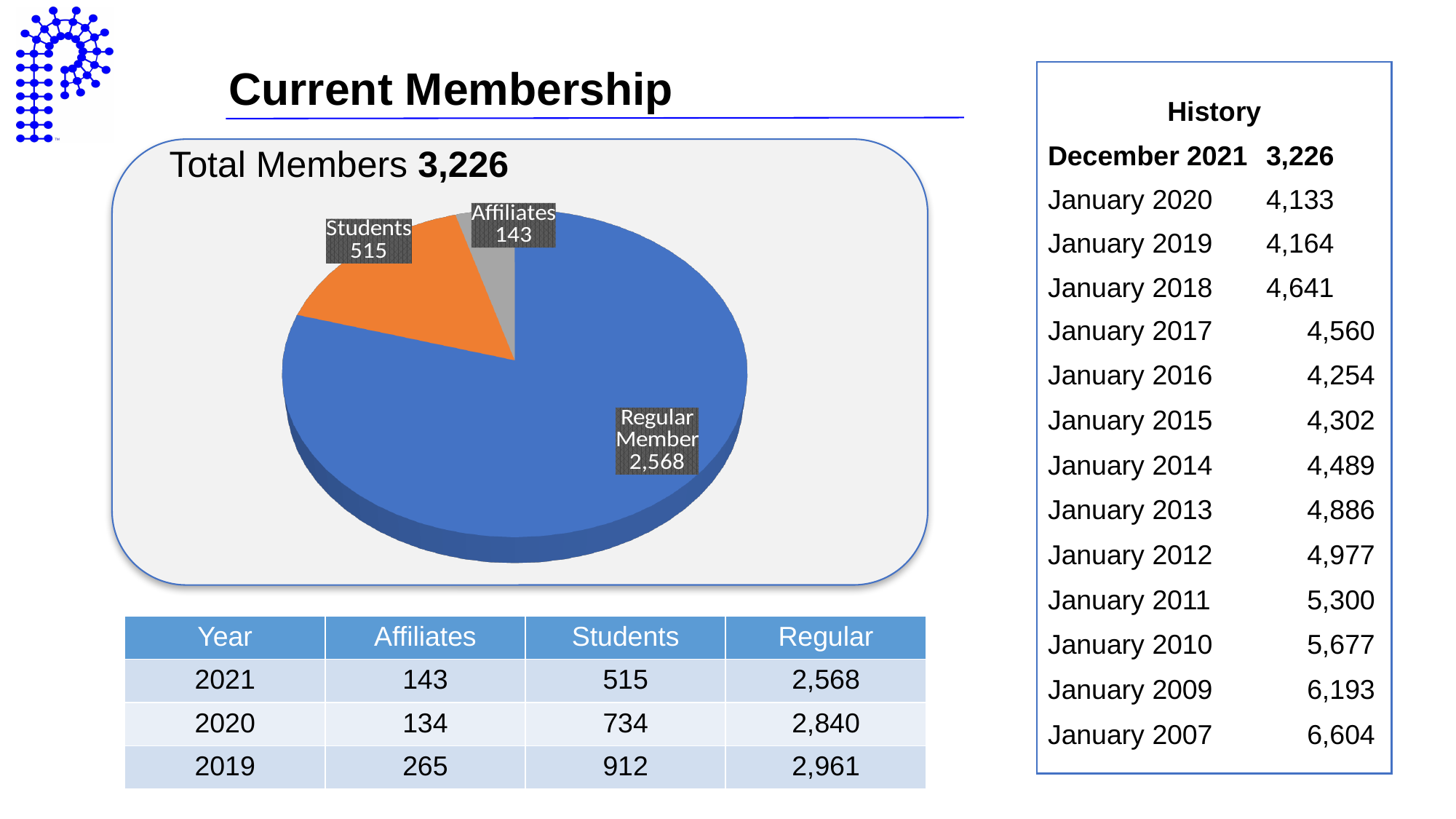
What is the value for Affiliates in the pie chart? 143 Which is larger in the pie chart, Students or Affiliates? Students What is the value for Regular Member in the pie chart? 2,568 What is the difference between the Regular Member and Students values in the pie chart? 2,053 Which category has the smallest slice in the pie chart? Affiliates How many slices does the pie chart have? 3 What colour is the Students slice in the pie chart? orange Which category has the largest slice in the pie chart? Regular Member What kind of chart is shown on the slide? pie chart What is the difference between the Students and Affiliates values in the pie chart? 372 What is the value for Students in the pie chart? 515 What is the total of all slices in the pie chart? 3,226